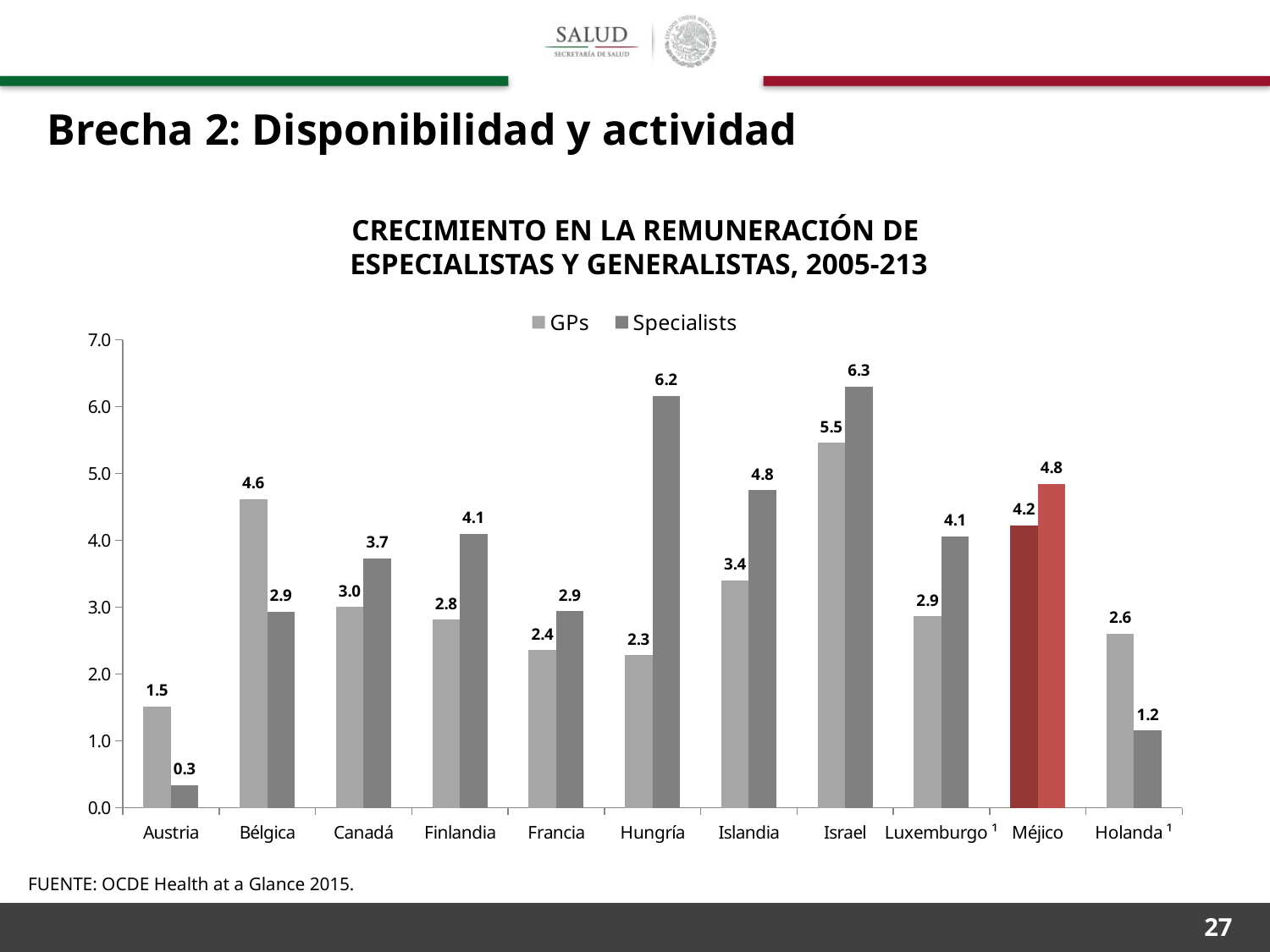
Which is larger for Bélgica, the GPs value or the Specialists value? GPs How many series does the legend list? 2 What is the GPs value for Hungría? 2.3 Which country has the lowest Specialists value? Austria What is the difference between the Specialists and GPs values for Hungría? 3.9 Which country's bars are highlighted in red? Méjico Which country has the highest GPs value? Israel How many countries are shown on the x axis? 11 Which country has the highest Specialists value? Israel What kind of chart is shown on the slide? Bar chart What is the Specialists value for Méjico? 4.8 What is the Specialists value for Finlandia? 4.1